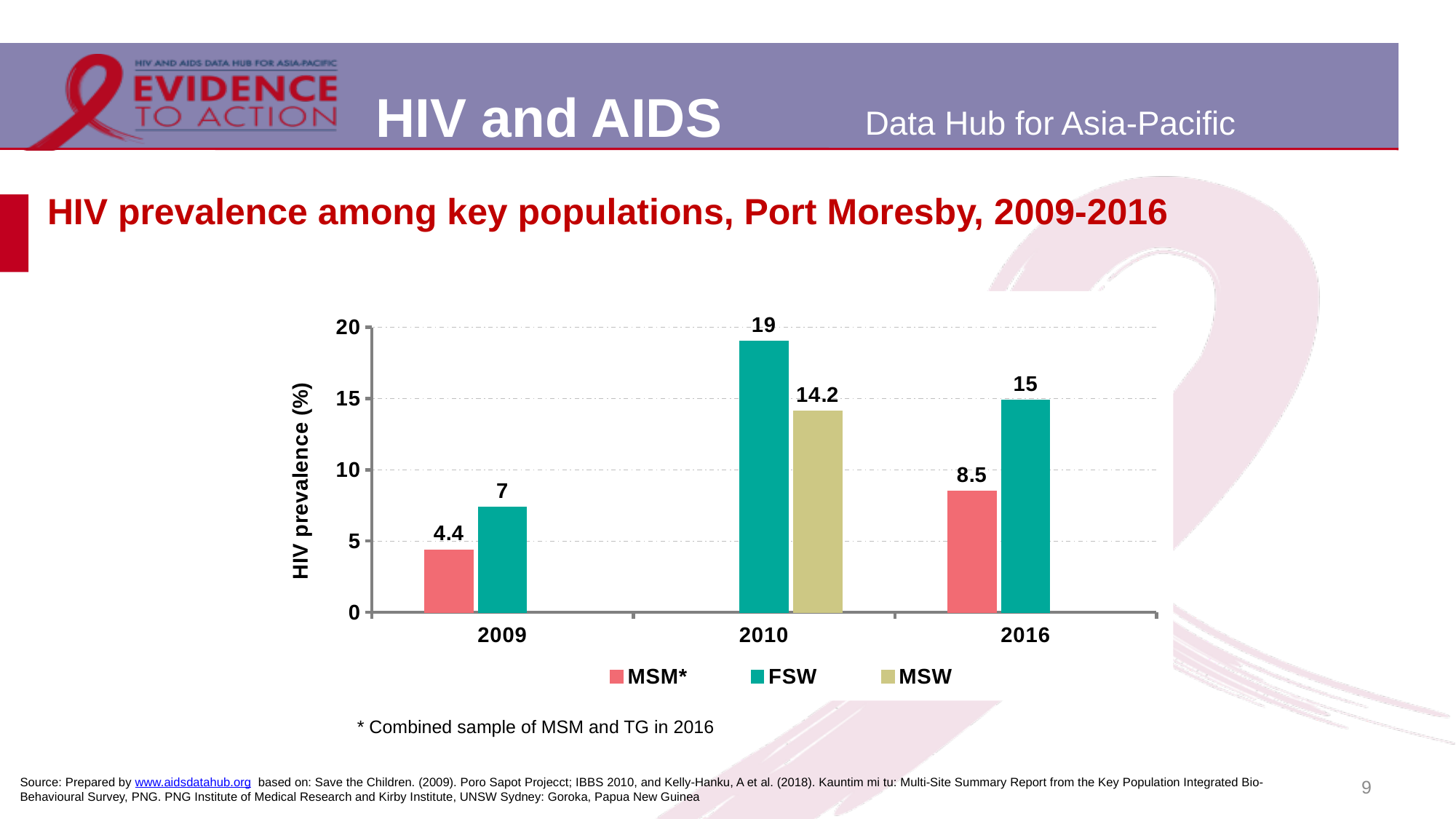
Which series has the lowest value in 2009? MSM* What kind of chart is shown on the slide? bar chart What is the HIV prevalence among MSM* in 2009? 4.4 What is the HIV prevalence among MSM* in 2016? 8.5 How many series does the legend list? 3 In which year is the FSW HIV prevalence highest? 2010 How many years are shown on the x axis? 3 What is the difference between the FSW and MSM* HIV prevalence in 2016? 6.5 Is the FSW value in 2009 greater or less than 10? less What is the HIV prevalence among FSW in 2010? 19 Which is larger in 2010, the FSW value or the MSW value? FSW What is the HIV prevalence among MSW in 2010? 14.2